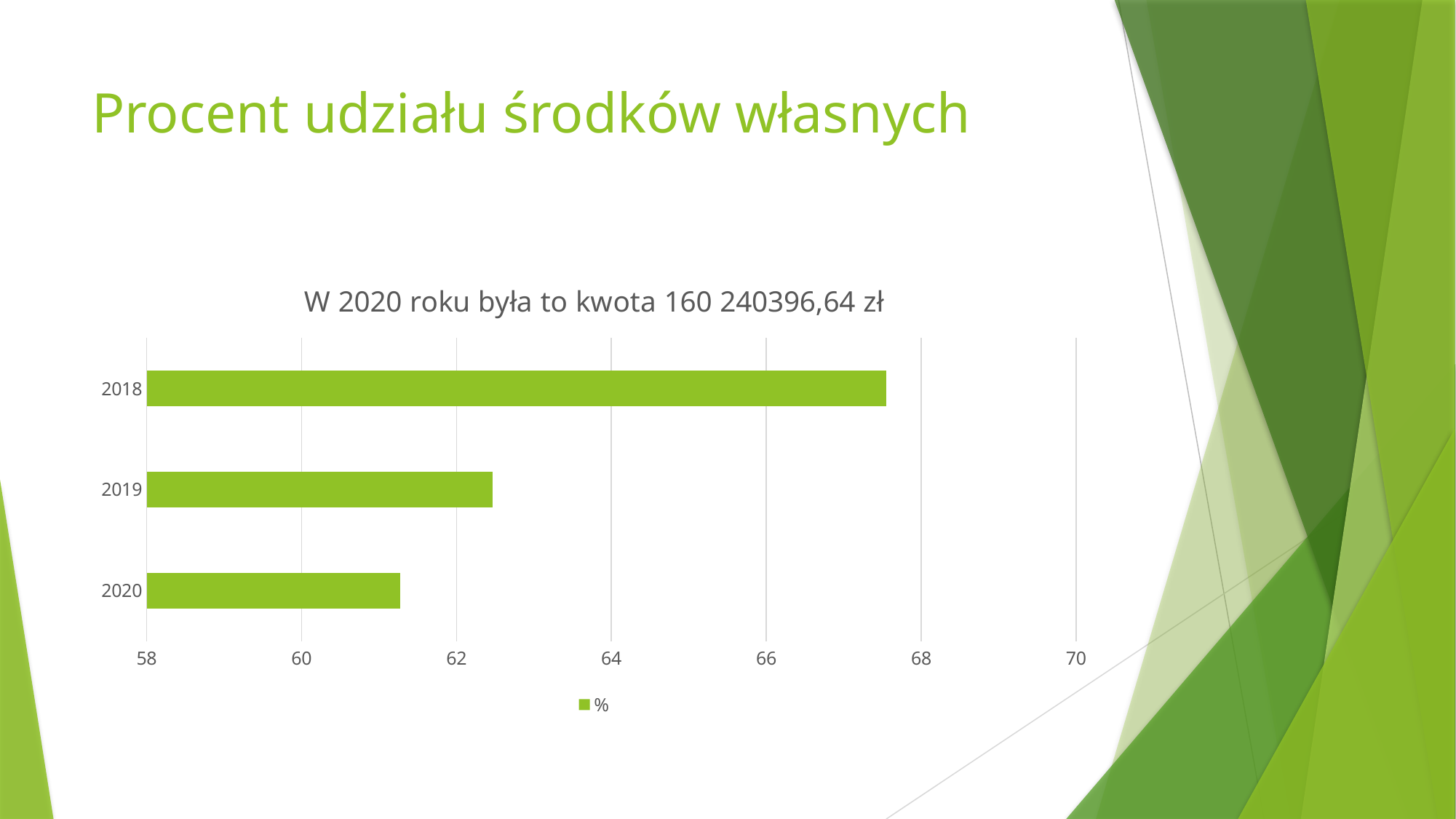
How many years (categories) are plotted in the chart? 3 What is the legend entry shown below the chart? % Is the value for 2018 greater or less than 66? greater Which has the larger value, 2019 or 2020? 2019 What kind of chart is shown on the slide? bar chart Which year has the highest value in the chart? 2018 Is the value for 2018 greater or less than 68? less Which has the larger value, 2018 or 2019? 2018 Do the values rise or fall going from 2018 to 2020? fall How many series does the chart legend list? 1 Which year has the lowest value in the chart? 2020 Is the value for 2020 greater or less than 62? less